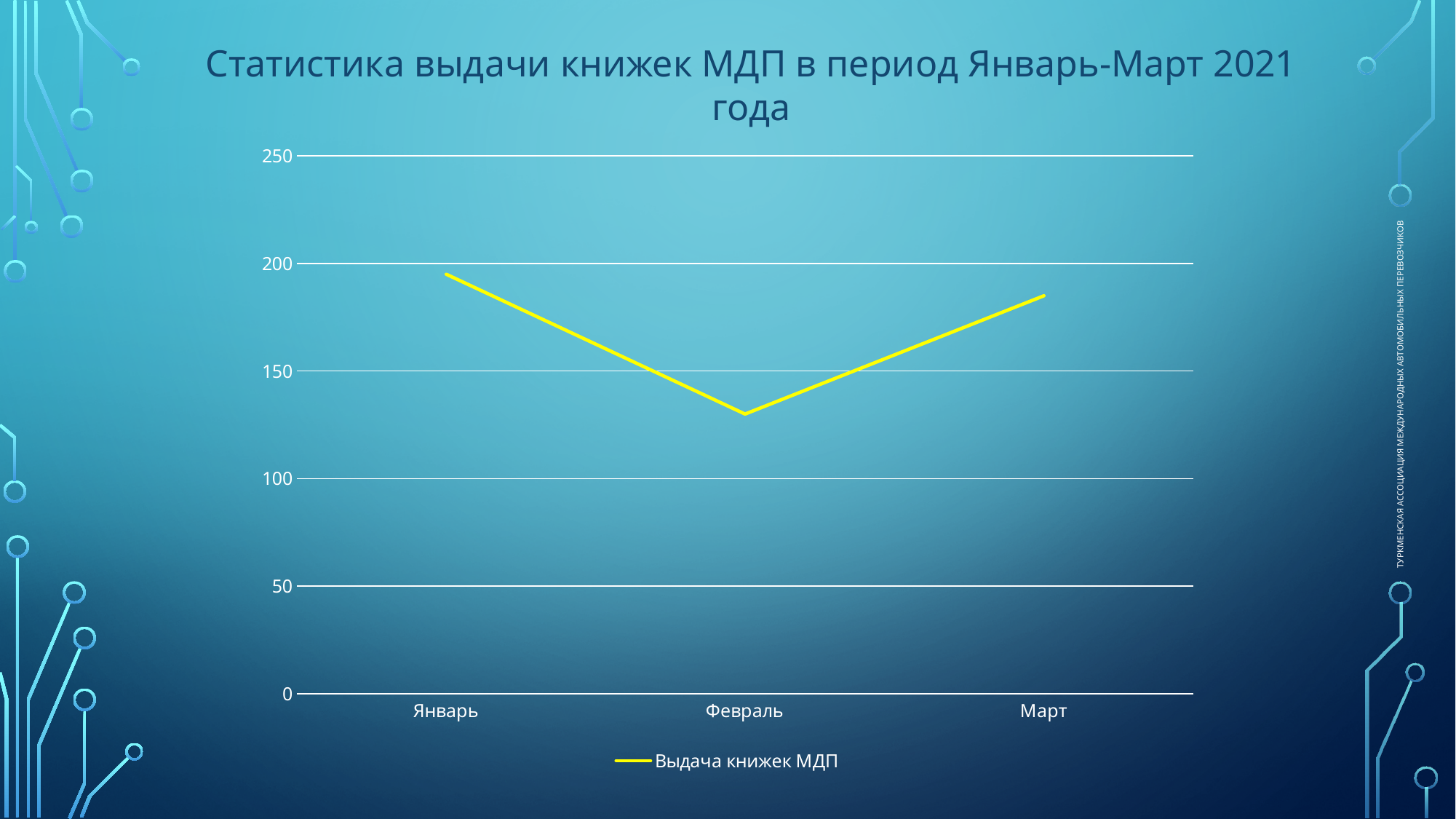
How many categories are shown on the x axis? 3 Is the value for Март greater or less than 200? less How does the value change from Январь to Февраль to Март? falls, then rises Which month has the lowest value? Февраль What is the name of the series shown in the legend? Выдача книжек МДП Which is larger, the value for Январь or the value for Февраль? Январь How many series does the legend list? 1 Is the value for Февраль greater or less than 100? greater Is the value for Февраль greater or less than 150? less What kind of chart is shown on the slide? line chart Which month has the highest value? Январь